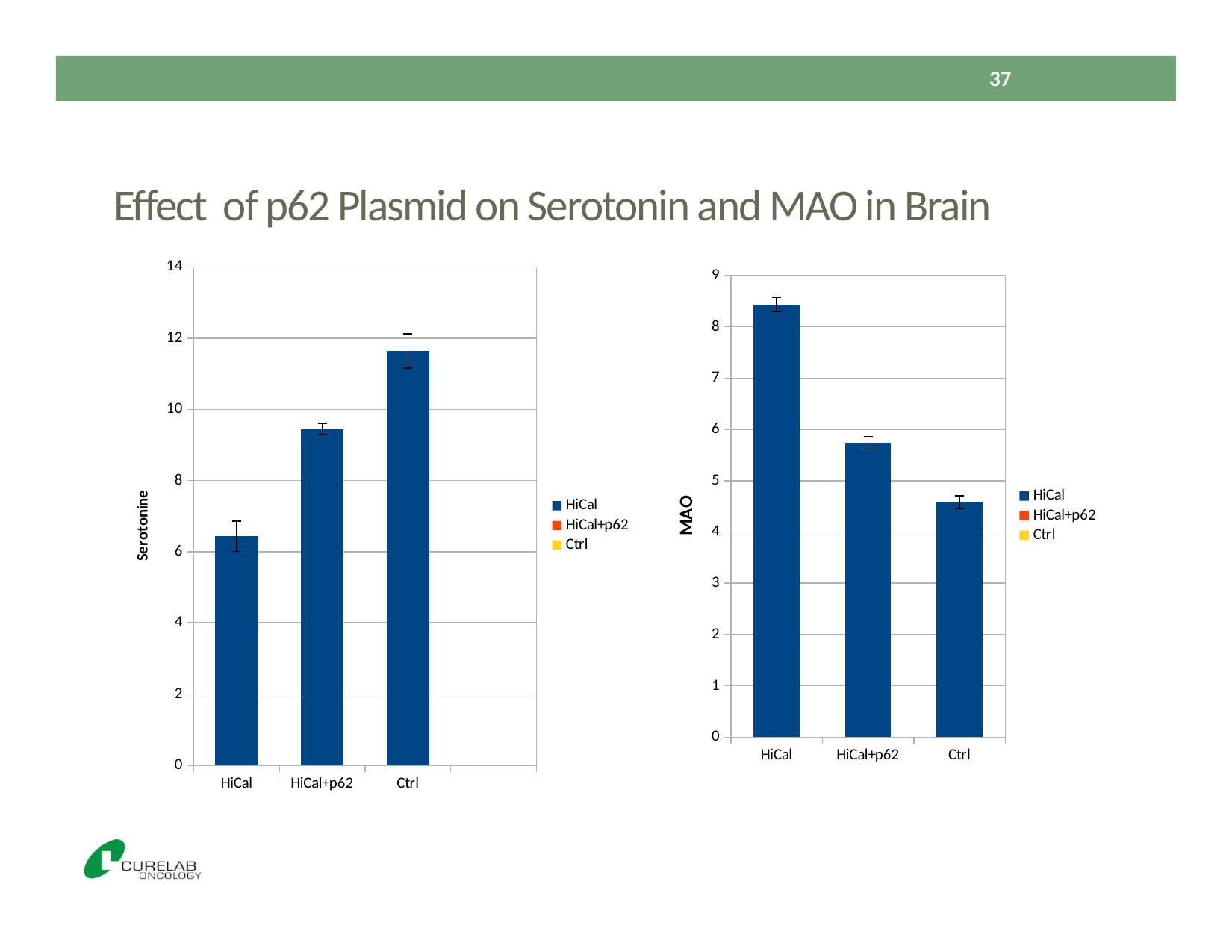
In the right chart (MAO), which category has the highest bar? HiCal In the left chart (Serotonine), how many categories are plotted on the x axis? 3 In the right chart (MAO), which is larger, the value for HiCal+p62 or the value for Ctrl? HiCal+p62 In the left chart (Serotonine), which category has the lowest bar? HiCal In the right chart (MAO), which category has the lowest bar? Ctrl In the left chart (Serotonine), do the bars rise or fall from HiCal to Ctrl along the x axis? rise In the left chart (Serotonine), is the value for HiCal+p62 greater or less than 8? greater In the left chart (Serotonine), is the value for HiCal greater or less than 8? less In the left chart (Serotonine), which category has the highest bar? Ctrl In the right chart (MAO), how many entries does the legend list? 3 In the left chart (Serotonine), what kind of chart is shown? bar chart In the right chart (MAO), is the value for HiCal greater or less than 8? greater